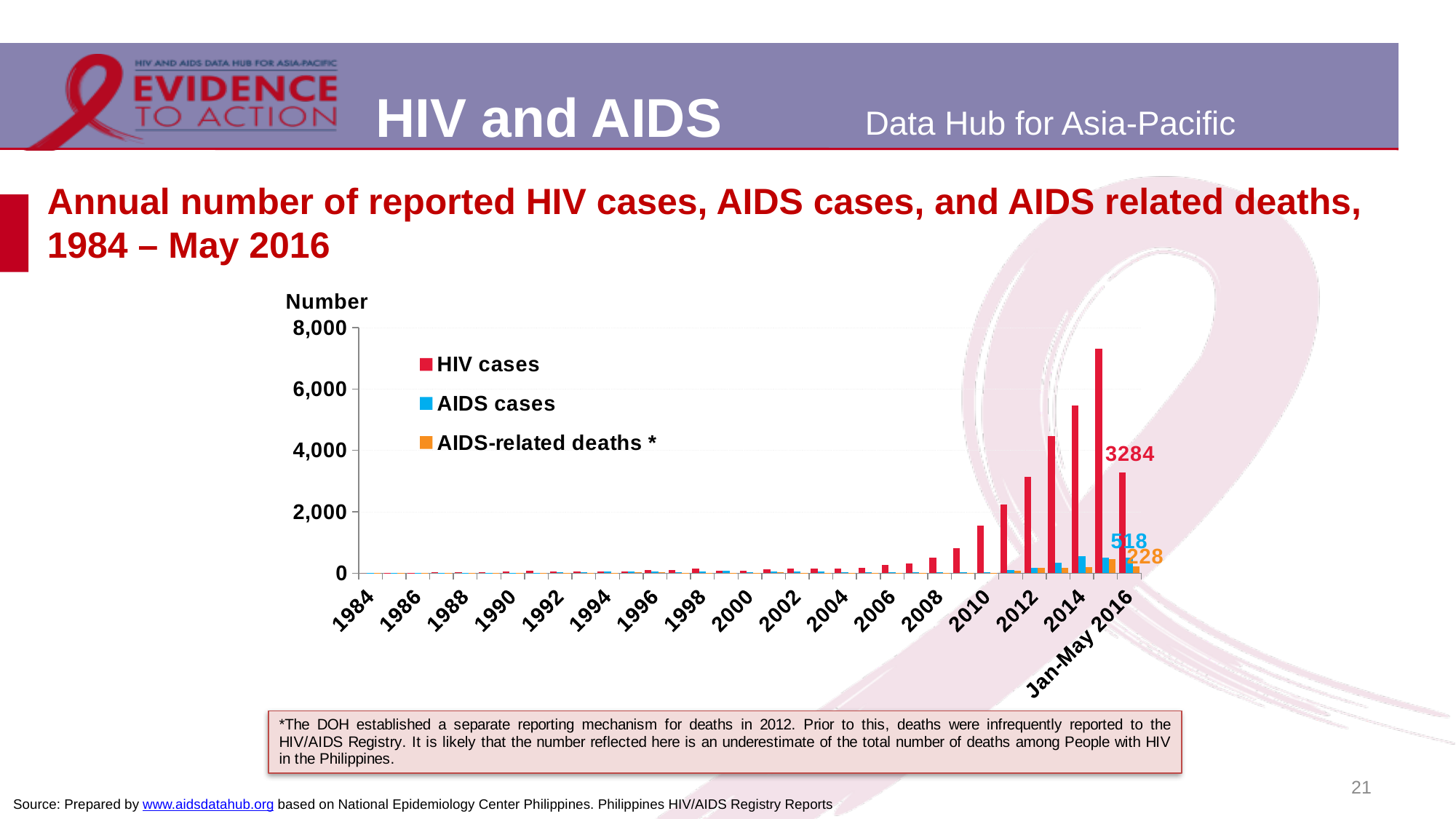
What is the number of AIDS cases for Jan-May 2016? 518 What is the difference between HIV cases and AIDS cases for Jan-May 2016? 2766 Is the number of HIV cases in 2015 greater or less than 6,000? greater What is the number of AIDS-related deaths for Jan-May 2016? 228 Which year has the highest number of HIV cases? 2015 Do the HIV cases generally rise or fall from 1984 to 2015? rise Which colour represents AIDS-related deaths in the chart? orange What is the number of HIV cases for Jan-May 2016? 3284 What is the difference between AIDS cases and AIDS-related deaths for Jan-May 2016? 290 Is the number of HIV cases in 2010 greater or less than 2,000? less How many series does the legend list? 3 What kind of chart is shown on the slide? bar chart